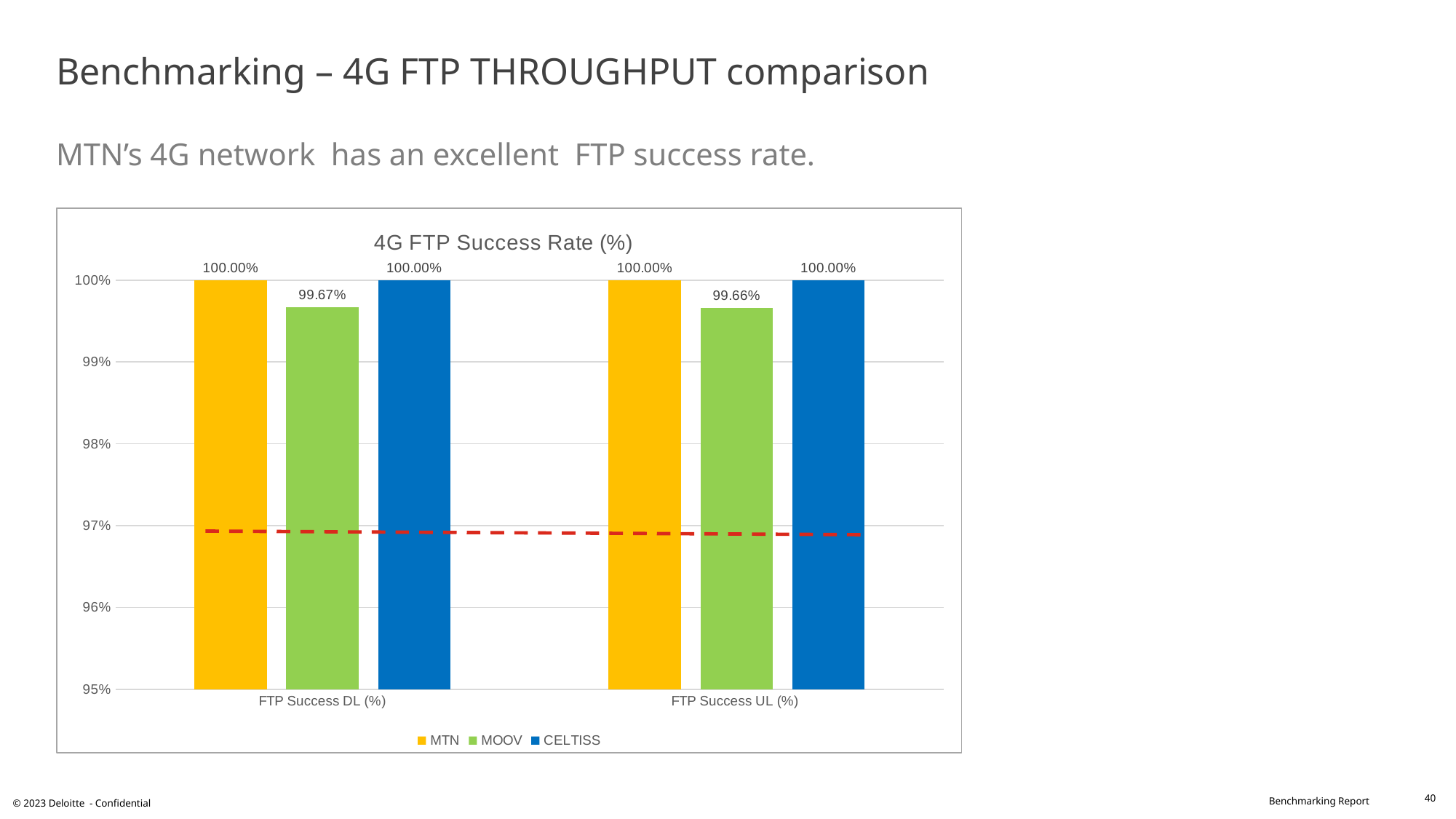
What is the value for CELTISS in the FTP Success DL (%) category? 100.00% What is the value for MOOV in the FTP Success UL (%) category? 99.66% What is the title of the chart? 4G FTP Success Rate (%) What is the difference between CELTISS and MOOV in the FTP Success UL (%) category? 0.34% What is the difference between MTN and MOOV in the FTP Success DL (%) category? 0.33% Which is larger, MTN's value or MOOV's value in the FTP Success UL (%) category? MTN Which operator has the lowest value in the FTP Success UL (%) category? MOOV What is the value for MTN in the FTP Success UL (%) category? 100.00% What is the value for MOOV in the FTP Success DL (%) category? 99.67% How many series does the legend list? 3 What kind of chart is shown on the slide? Bar chart Which operator has the lowest value in the FTP Success DL (%) category? MOOV